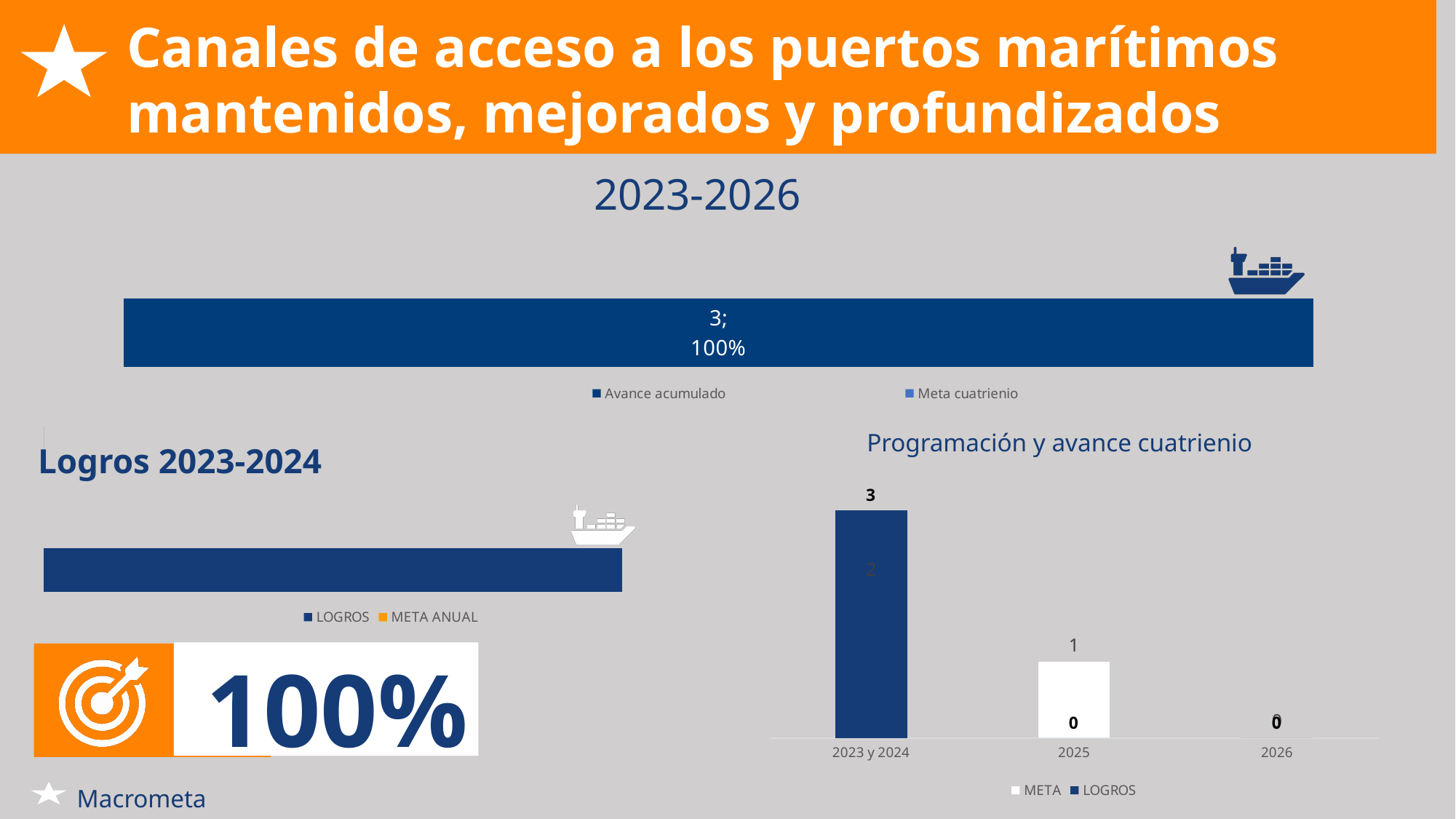
In the 'Programación y avance cuatrienio' chart, what is the LOGROS value for 2025? 0 In the 'Programación y avance cuatrienio' chart, what is the META value for 2025? 1 In the 'Programación y avance cuatrienio' chart, do the LOGROS values rise or fall from 2023 y 2024 to 2026? fall In the 'Programación y avance cuatrienio' chart, what is the LOGROS value for 2023 y 2024? 3 In the 'Logros 2023-2024' chart, what are the two legend entries? LOGROS and META ANUAL In the top '2023-2026' chart, what data label is shown on the bar? 3; 100% What kind of chart is 'Programación y avance cuatrienio'? bar chart In the 'Programación y avance cuatrienio' chart, what is the difference between the LOGROS value for 2023 y 2024 and the META value for 2025? 2 In the 'Programación y avance cuatrienio' chart, how many series does the legend list? 2 In the 'Programación y avance cuatrienio' chart, is the LOGROS value for 2023 y 2024 larger or smaller than the META value for 2025? larger In the 'Programación y avance cuatrienio' chart, which category has the highest LOGROS value? 2023 y 2024 In the 'Programación y avance cuatrienio' chart, how many categories are shown on the x axis? 3